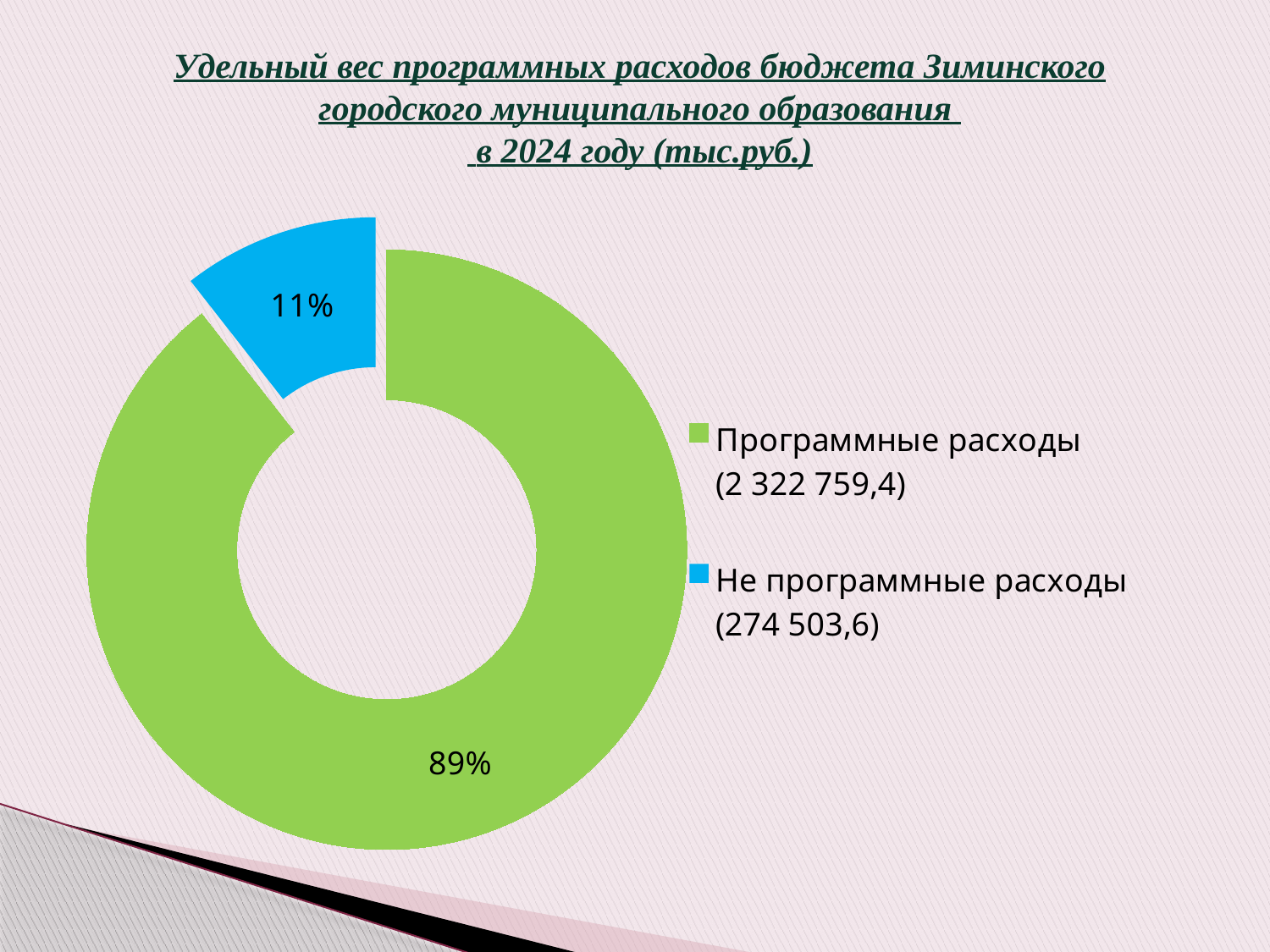
What is the value shown in the legend for Не программные расходы? 274 503,6 How many categories are shown in the chart? 2 Which is larger, Программные расходы or Не программные расходы? Программные расходы What colour is the slice for Не программные расходы? Blue Which year does the chart title refer to? 2024 What kind of chart is shown on the slide? Doughnut (pie) chart What is the difference between the values for Программные расходы and Не программные расходы? 2 048 255,8 Which category has the largest slice of the chart? Программные расходы What is the value shown in the legend for Программные расходы? 2 322 759,4 What share of the pie does Программные расходы take? 89% What share of the pie does Не программные расходы take? 11% Which category has the smallest slice of the chart? Не программные расходы